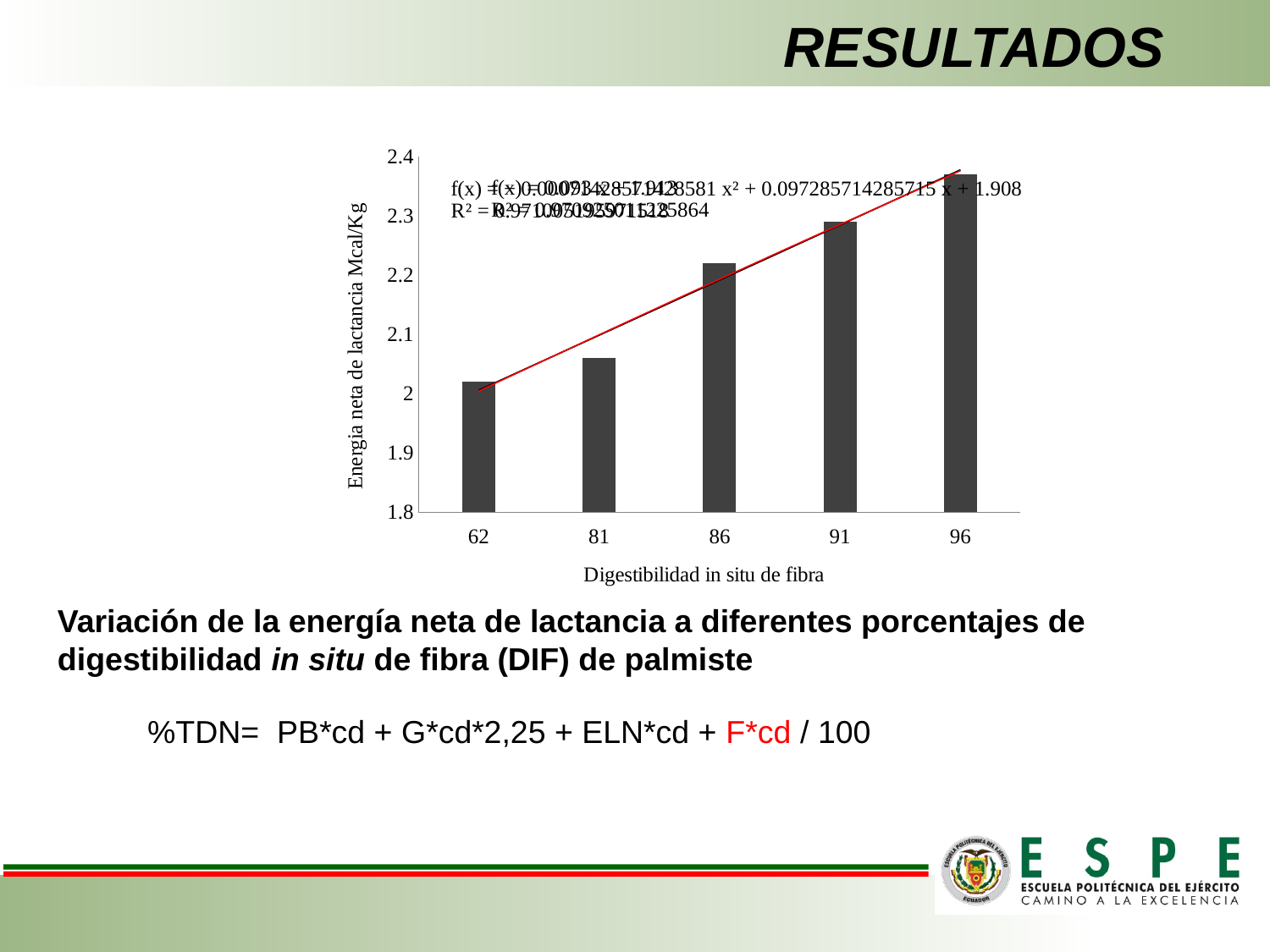
Is the value for digestibility 81 greater or less than 2.1? less Which digestibility value has the lowest energía neta de lactancia? 62 What is the label of the x axis of the chart? Digestibilidad in situ de fibra Do the bar values rise or fall as digestibilidad in situ de fibra increases along the x axis? rise What kind of chart is shown on the slide? bar chart How many bars (categories) are plotted in the chart? 5 What is the label of the y axis of the chart? Energia neta de lactancia Mcal/Kg Which digestibility value has the highest energía neta de lactancia? 96 Is the value for digestibility 62 greater or less than 2.1? less Is the value for digestibility 96 greater or less than 2.3? greater Which has a larger energía neta de lactancia: digestibility 86 or digestibility 91? 91